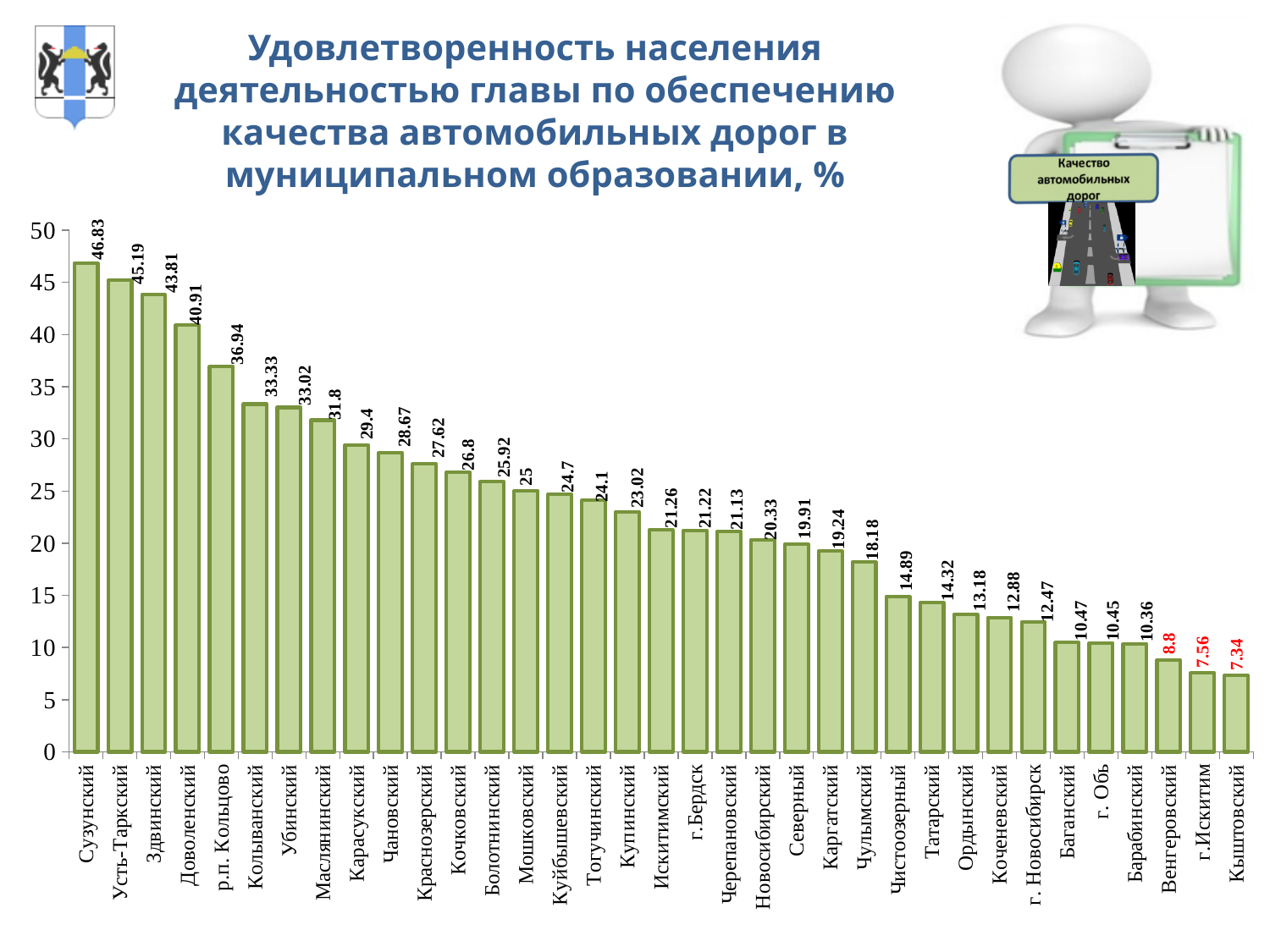
What is the value for Сузунский? 46.83 Which category has the lowest value? Кыштовский Is the value for Доволенский greater or less than 40? greater What kind of chart is shown on the slide? bar chart Do the values rise or fall from left to right along the x axis? fall What is the difference between the values for Сузунский and Усть-Таркский? 1.64 Which category has the highest value? Сузунский What is the value for Кыштовский? 7.34 Which is larger, the value for Карасукский or the value for Чановский? Карасукский How many categories are shown on the chart? 35 What is the value for г. Новосибирск? 12.47 What is the value for р.п. Кольцово? 36.94